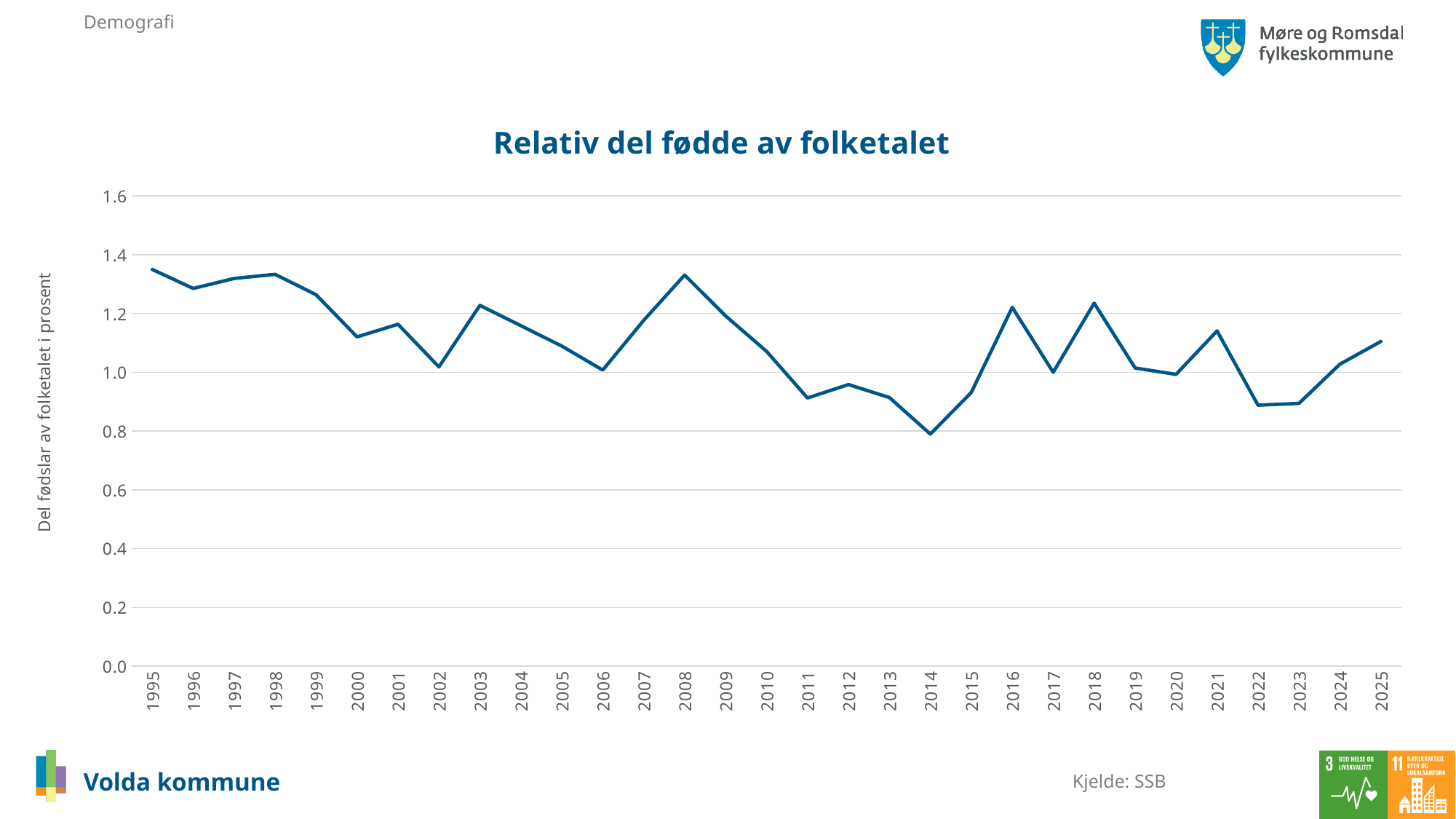
Is the value for 1995 greater or less than 1.2? greater What is the title of the chart? Relativ del fødde av folketalet Which year has the larger value, 2008 or 2011? 2008 What is the label on the vertical axis of the chart? Del fødslar av folketalet i prosent Does the value rise or fall from 2014 to 2016? rise Which year has the lowest value in the chart? 2014 Which year has the larger value, 2016 or 2017? 2016 How many years are plotted along the x axis of the chart? 31 Is the value for 2025 greater or less than 1.0? greater Is the value for 2014 greater or less than 1.0? less What kind of chart is shown on the slide? line chart